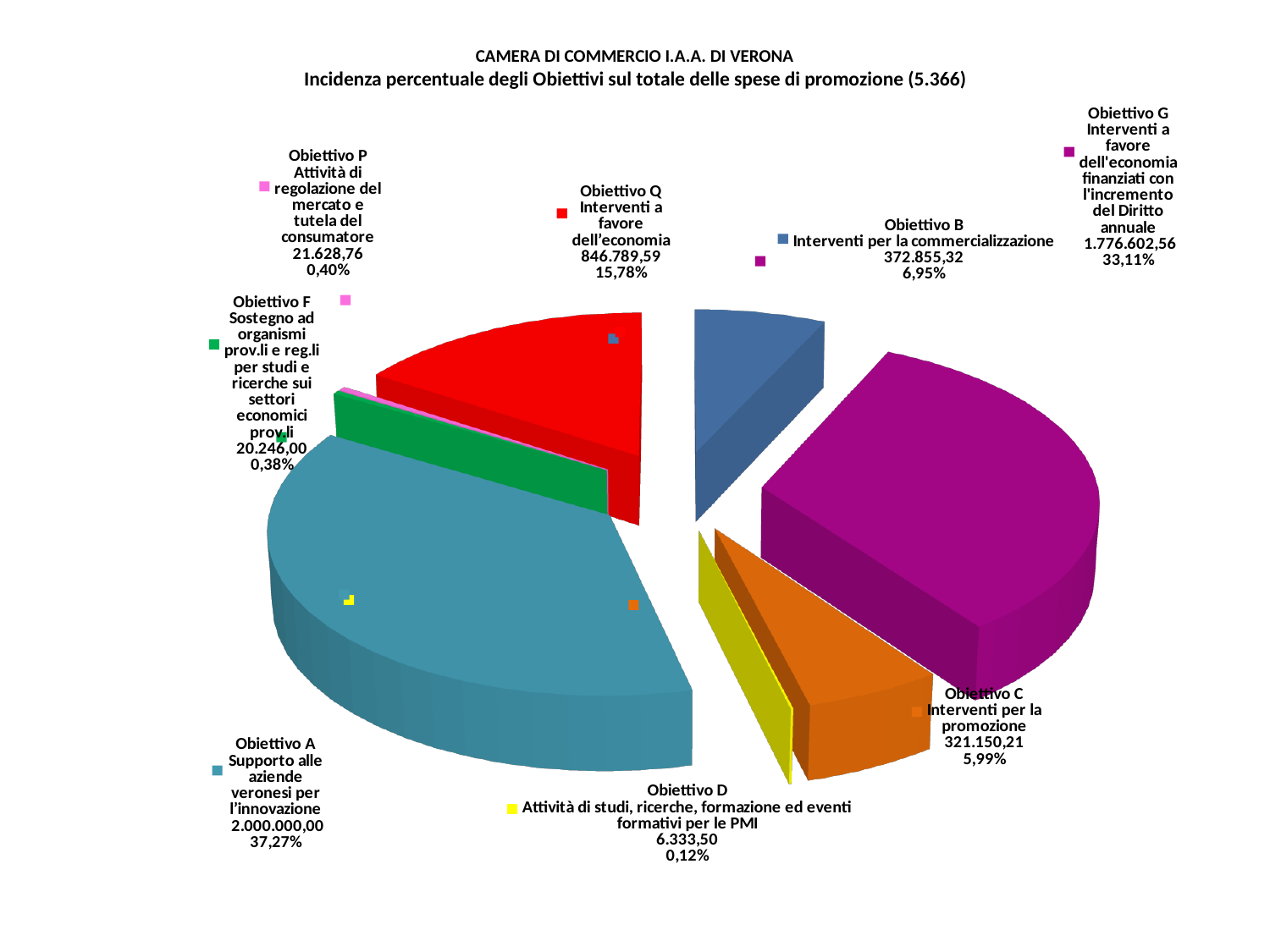
What is the value shown for Obiettivo P (Attività di regolazione del mercato e tutela del consumatore)? 21.628,76 What is the value shown for Obiettivo Q (Interventi a favore dell'economia)? 846.789,59 Which objective has the smallest share of the pie? Obiettivo D What is the value shown for Obiettivo A (Supporto alle aziende veronesi per l'innovazione)? 2.000.000,00 What is the title of the chart? Incidenza percentuale degli Obiettivi sul totale delle spese di promozione (5.366) What is the difference in percentage points between the shares of Obiettivo A and Obiettivo G? 4,16% Which has a larger share, Obiettivo B or Obiettivo C? Obiettivo B What percentage share does Obiettivo G have? 33,11% What percentage share does Obiettivo D (Attività di studi, ricerche, formazione ed eventi formativi per le PMI) have? 0,12% What kind of chart is shown on the slide? Pie chart Which objective has the largest share of the pie? Obiettivo A How many slices (objectives) does the pie chart have? 8